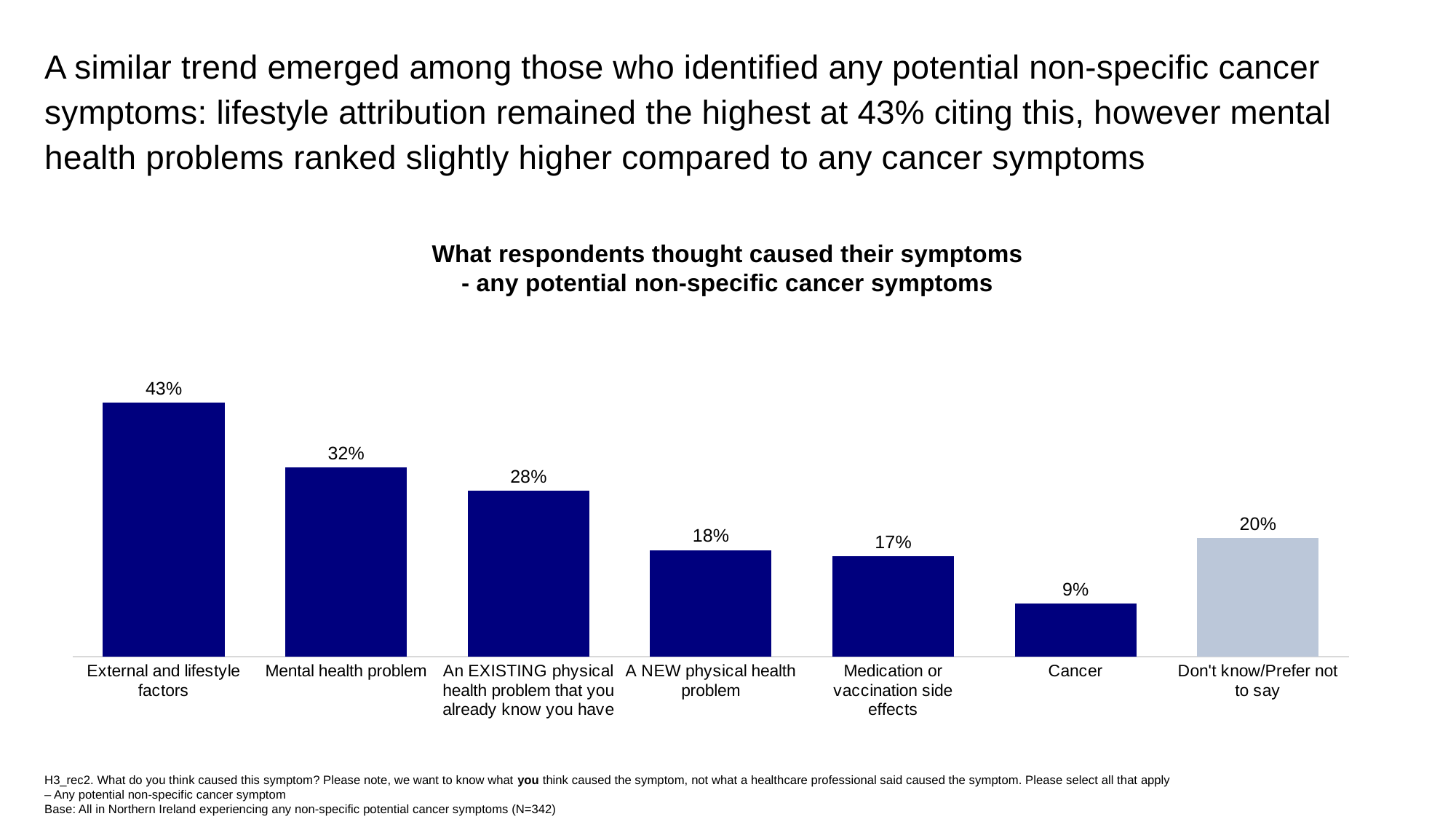
What is the difference between the values for External and lifestyle factors and Mental health problem? 11 percentage points What percentage of respondents attributed their symptoms to Cancer? 9% Which category has the lowest value? Cancer What is the difference between the values for An EXISTING physical health problem that you already know you have and Cancer? 19 percentage points Which bar is shown in a lighter colour than the others? Don't know/Prefer not to say Which category has the highest value? External and lifestyle factors How many categories are shown on the chart? 7 What kind of chart is shown on the slide? Bar chart What percentage of respondents attributed their symptoms to external and lifestyle factors? 43% What is the value shown for Mental health problem? 32% Which is larger: the value for A NEW physical health problem or the value for Medication or vaccination side effects? A NEW physical health problem What is the value for Don't know/Prefer not to say? 20%